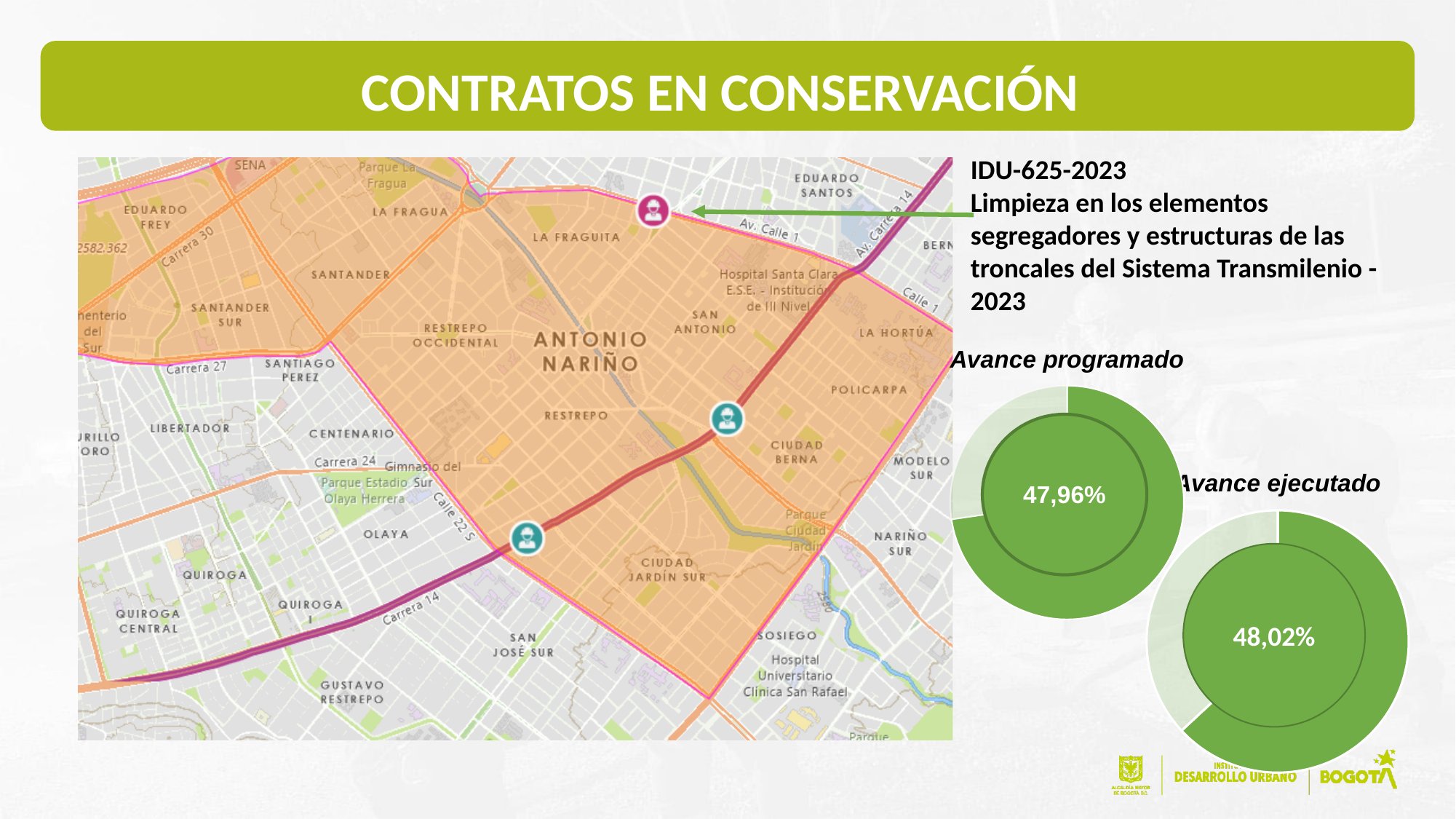
What is the title of the doughnut chart on the lower right of the two charts? Avance ejecutado Which is larger, the value in the 'Avance programado' chart or the value in the 'Avance ejecutado' chart? Avance ejecutado What is the difference between the 'Avance ejecutado' value and the 'Avance programado' value? 0,06% How many doughnut charts are shown on the slide? 2 Which contract code is shown next to the charts on the slide? IDU-625-2023 What is the title of the doughnut chart on the upper left of the two charts? Avance programado What kind of chart is used for 'Avance ejecutado'? Doughnut chart What value is shown in the centre of the 'Avance ejecutado' chart? 48,02% What kind of chart is used for 'Avance programado'? Doughnut chart What value is shown in the centre of the 'Avance programado' chart? 47,96%